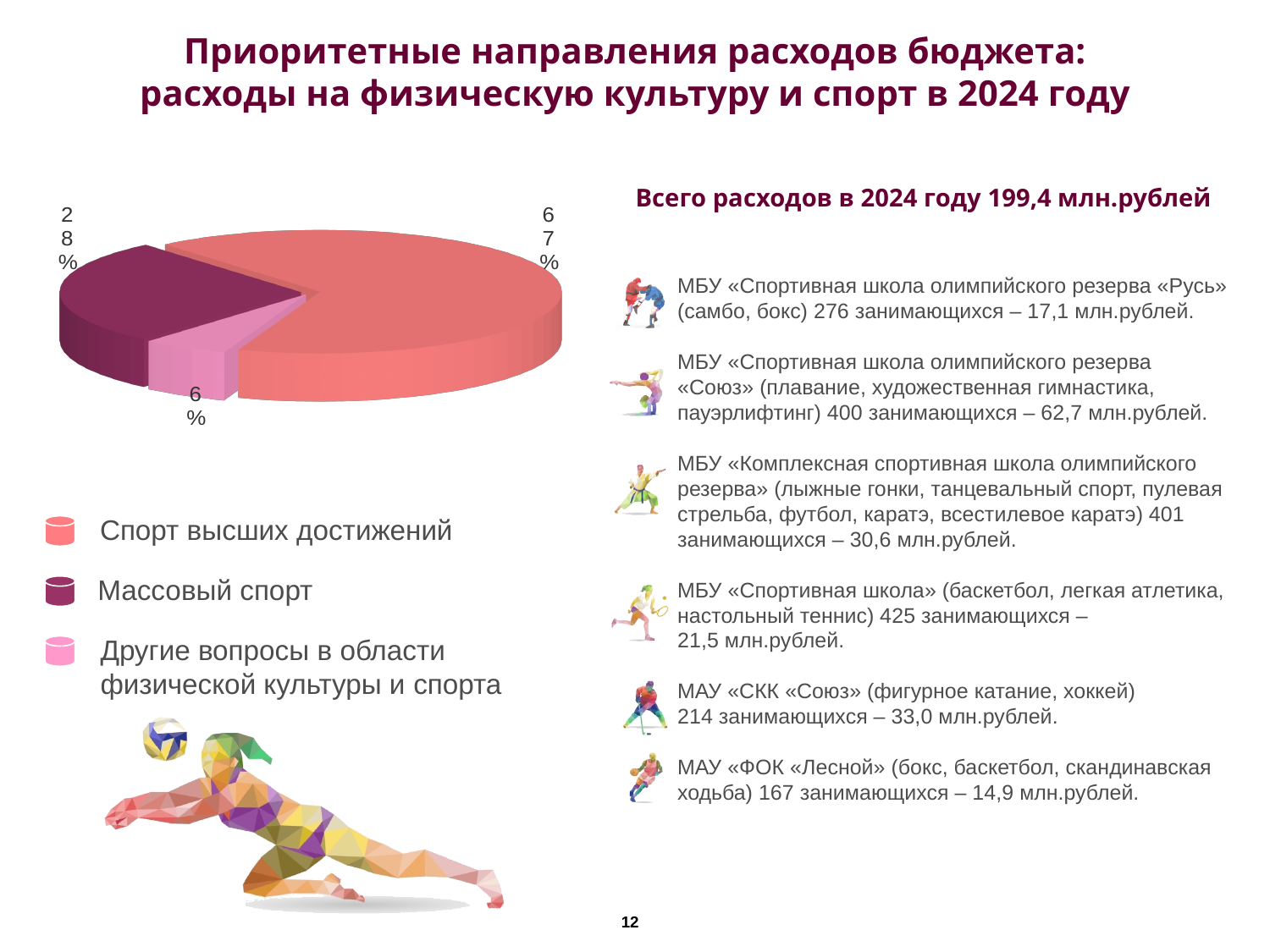
Which is larger: the slice for "Массовый спорт" or the slice for "Другие вопросы в области физической культуры и спорта"? Массовый спорт How many entries does the legend of the pie chart list? 3 Which category has the smallest slice of the pie? Другие вопросы в области физической культуры и спорта Is the share for "Массовый спорт" greater or less than 50%? less What share of the pie does "Спорт высших достижений" have? 67% What kind of chart is shown on the slide? pie chart What share of the pie does "Массовый спорт" have? 28% Which category has the largest slice of the pie? Спорт высших достижений What is the difference in percentage points between the "Спорт высших достижений" slice and the "Массовый спорт" slice? 39 Which legend entry is shown in the dark magenta colour? Массовый спорт How many slices does the pie chart have? 3 What share of the pie does "Другие вопросы в области физической культуры и спорта" have? 6%